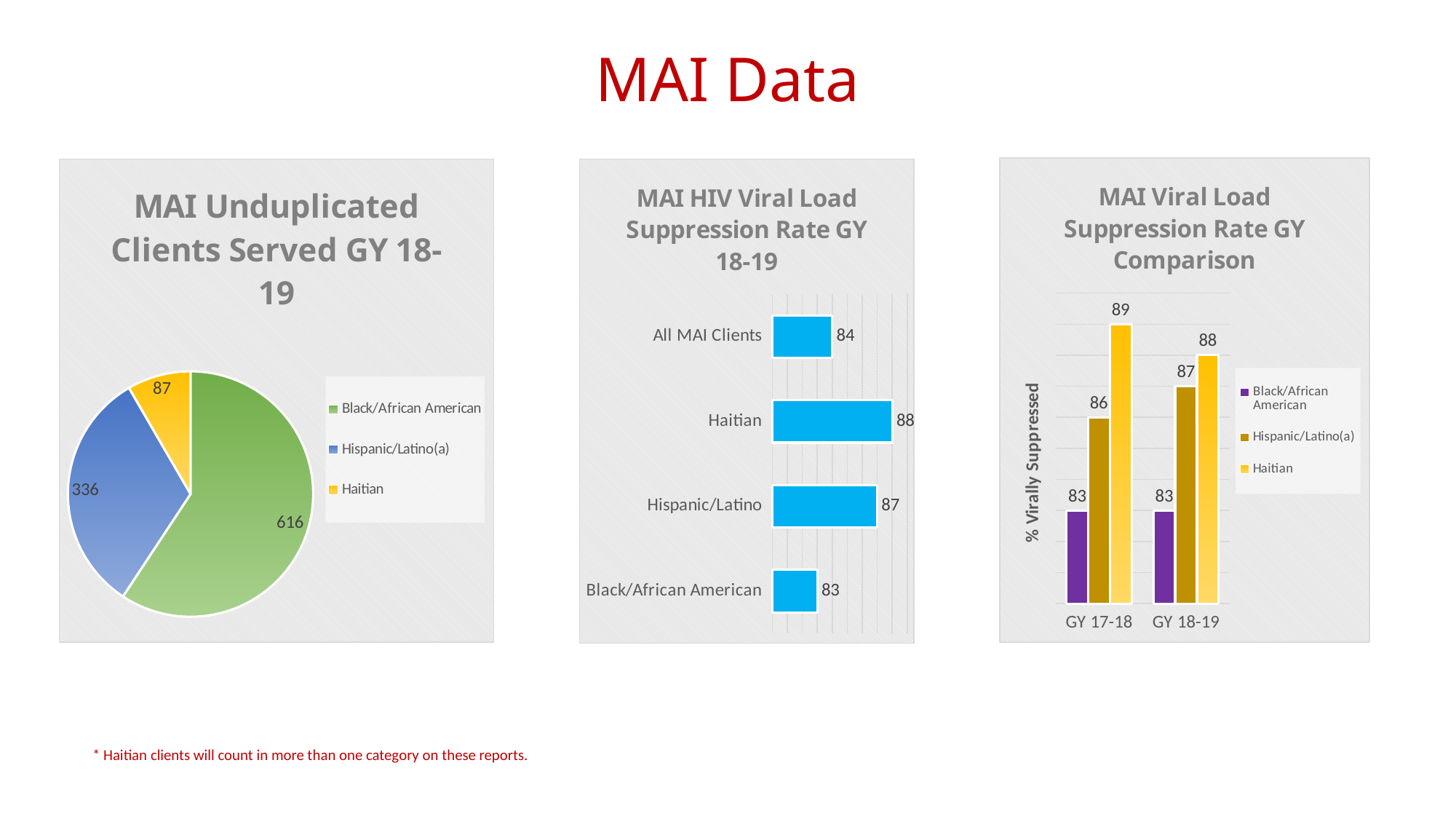
In the 'MAI Viral Load Suppression Rate GY Comparison' chart, is the Hispanic/Latino(a) value larger in GY 17-18 or GY 18-19? GY 18-19 How many categories are shown in the 'MAI HIV Viral Load Suppression Rate GY 18-19' chart? 4 In the 'MAI Unduplicated Clients Served GY 18-19' pie chart, how many Black/African American clients were served? 616 In the 'MAI Viral Load Suppression Rate GY Comparison' chart, what is the Haitian value for GY 17-18? 89 In the 'MAI Viral Load Suppression Rate GY Comparison' chart, how many series does the legend list? 3 In the 'MAI HIV Viral Load Suppression Rate GY 18-19' chart, what is the value for All MAI Clients? 84 What type of chart is 'MAI HIV Viral Load Suppression Rate GY 18-19'? Bar chart What type of chart is 'MAI Unduplicated Clients Served GY 18-19'? Pie chart In the 'MAI Viral Load Suppression Rate GY Comparison' chart, what is the difference between the Haitian and Black/African American values for GY 18-19? 5 In the 'MAI Unduplicated Clients Served GY 18-19' pie chart, which category has the smallest slice? Haitian In the 'MAI Unduplicated Clients Served GY 18-19' pie chart, what is the difference between the Black/African American and Hispanic/Latino(a) values? 280 In the 'MAI HIV Viral Load Suppression Rate GY 18-19' chart, which category has the highest value? Haitian